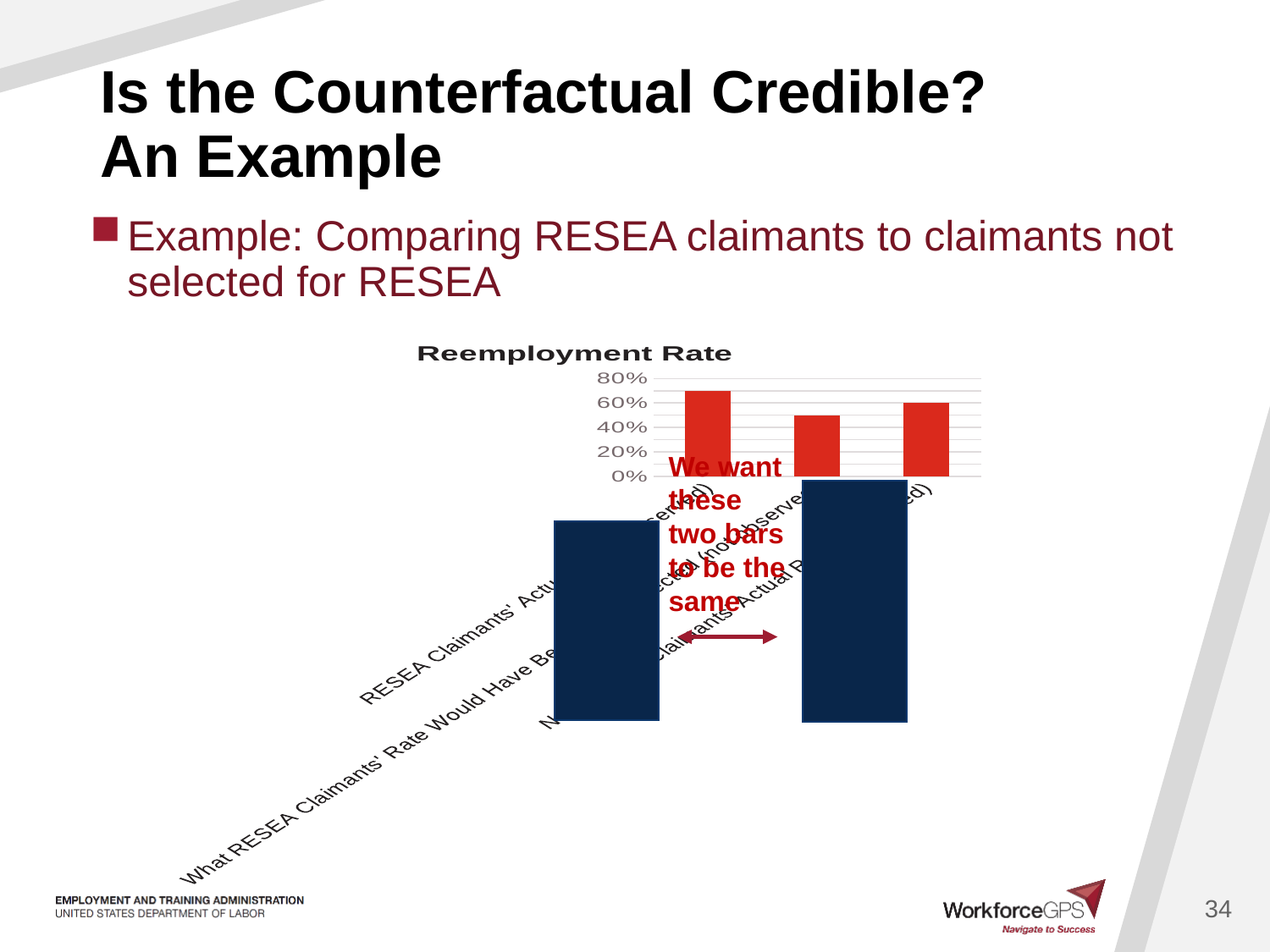
In the Reemployment Rate chart, is the value of the second (middle) bar greater or less than 60%? less What is the title of the chart on the slide? Reemployment Rate In the Reemployment Rate chart, which is larger: the first bar or the second bar? the first bar In the Reemployment Rate chart, does the value fall or rise from the first bar to the second bar? fall How many bars are plotted in the Reemployment Rate chart? 3 In the Reemployment Rate chart, which bar is the tallest: the first, second or third from the left? the first What is the highest value shown on the vertical axis of the Reemployment Rate chart? 80% In the Reemployment Rate chart, is the value of the third (rightmost) bar greater or less than 40%? greater In the Reemployment Rate chart, is the value of the second (middle) bar greater or less than 40%? greater In the Reemployment Rate chart, which bar is the shortest: the first, second or third from the left? the second What kind of chart is shown on the slide? bar chart